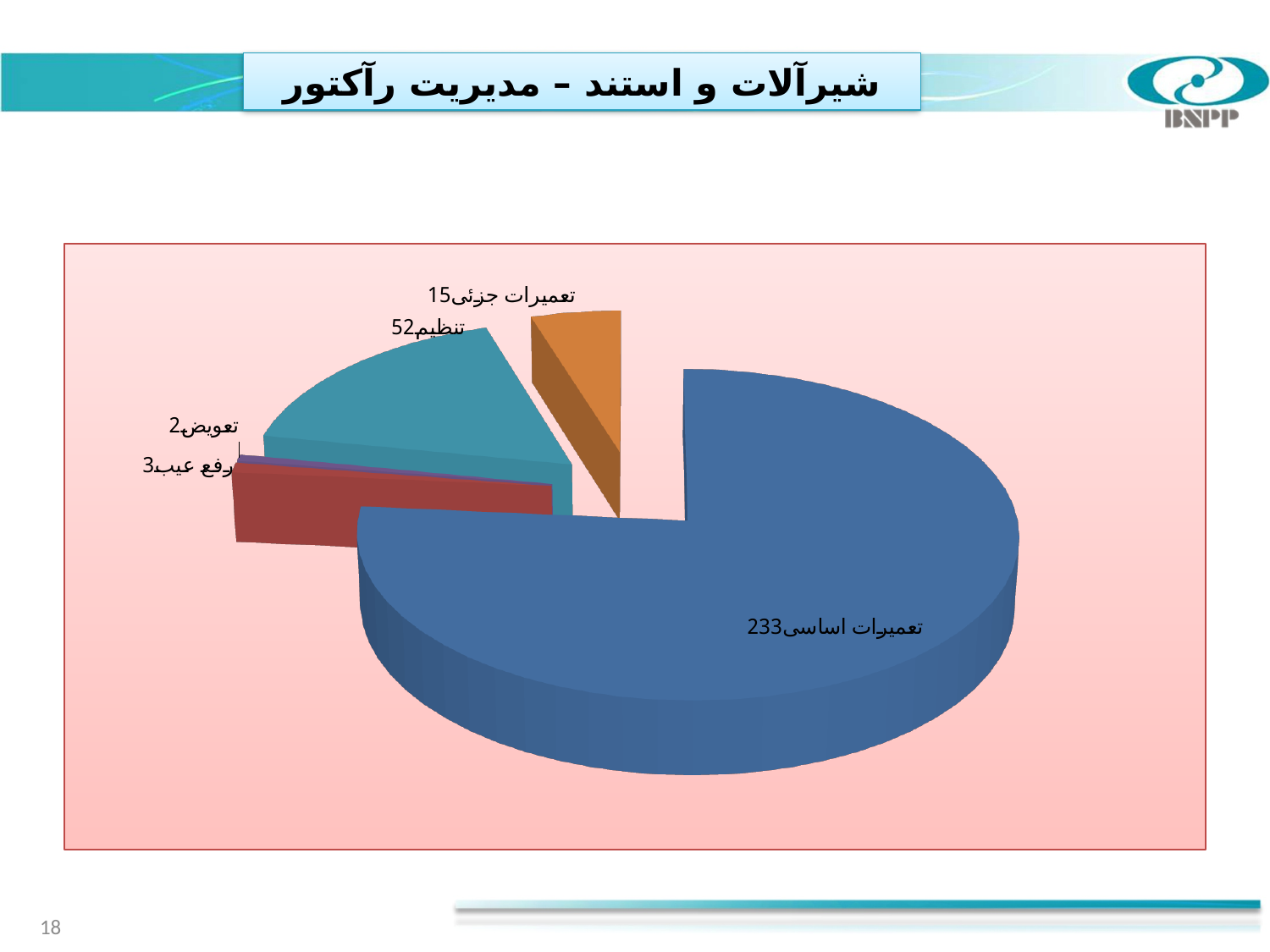
Which is larger, the value for تنظیم or the value for تعمیرات جزئی? تنظیم How many categories (slices) does the pie chart have? 5 What is the title of the slide containing the pie chart? شیرآلات و استند - مدیریت رآکتور What is the value for رفع عیب in the pie chart? 3 What is the value for تعمیرات اساسی in the pie chart? 233 What is the value for تعویض in the pie chart? 2 Which category has the largest slice in the pie chart? تعمیرات اساسی Which category has the smallest slice in the pie chart? تعویض What is the value for تعمیرات جزئی in the pie chart? 15 What is the value for تنظیم in the pie chart? 52 What kind of chart is shown on the slide? pie chart What is the difference between the values for تعمیرات اساسی and تنظیم? 181